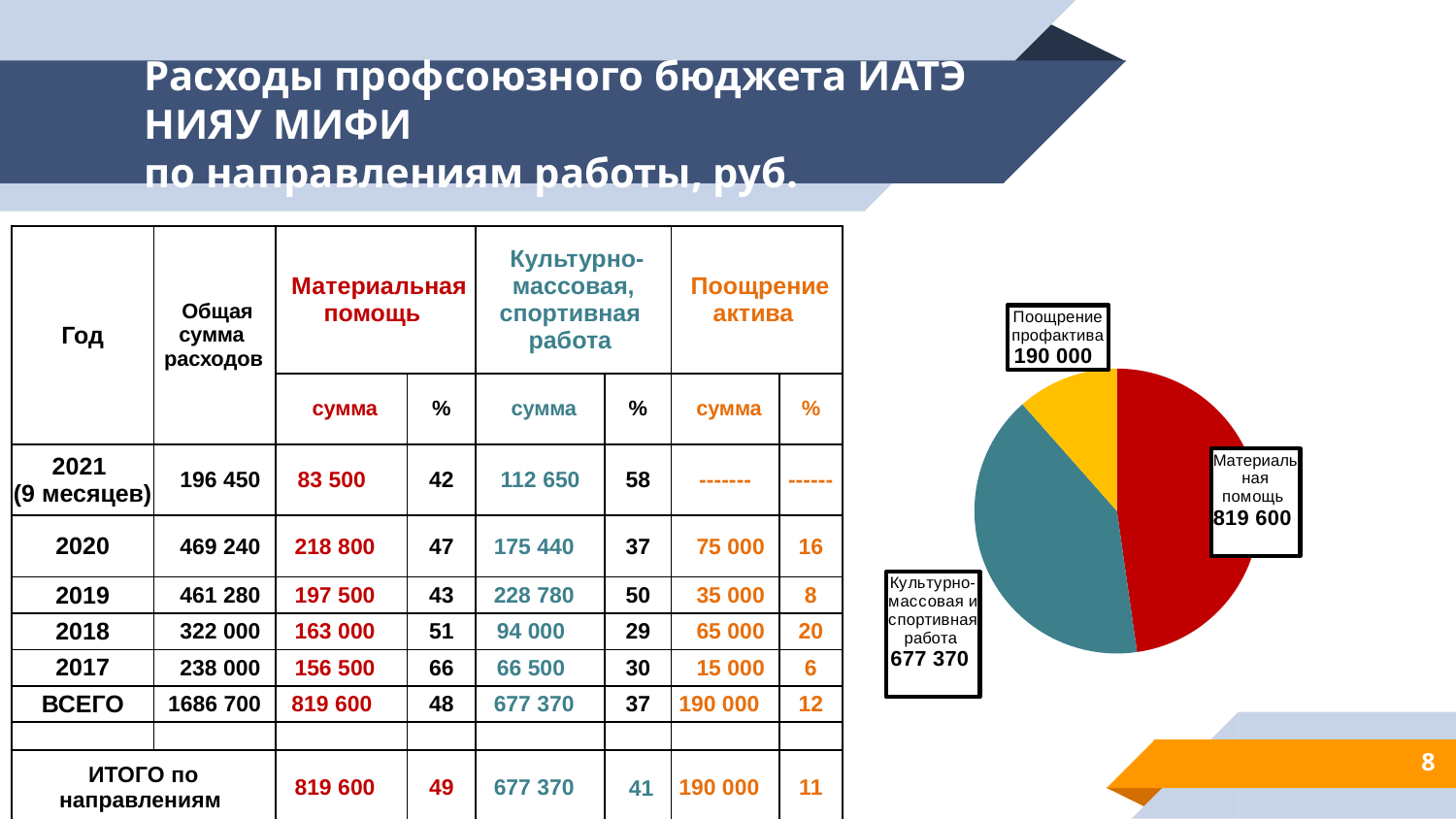
How many slices does the pie chart have? 3 Which slice of the pie chart is the smallest? Поощрение профактива What kind of chart is shown on the right side of the slide? pie chart What is the total of all three slices in the pie chart? 1 686 970 In the pie chart, which is larger: Материальная помощь or Поощрение профактива? Материальная помощь In the pie chart, what is the difference between Материальная помощь and Культурно-массовая и спортивная работа? 142 230 In the pie chart, what is the value for Материальная помощь? 819 600 In the pie chart, what is the value for Поощрение профактива? 190 000 In the pie chart, what is the value for Культурно-массовая и спортивная работа? 677 370 Which slice of the pie chart is the largest? Материальная помощь In the pie chart, what is the difference between Культурно-массовая и спортивная работа and Поощрение профактива? 487 370 What colour is the Поощрение профактива slice in the pie chart? yellow